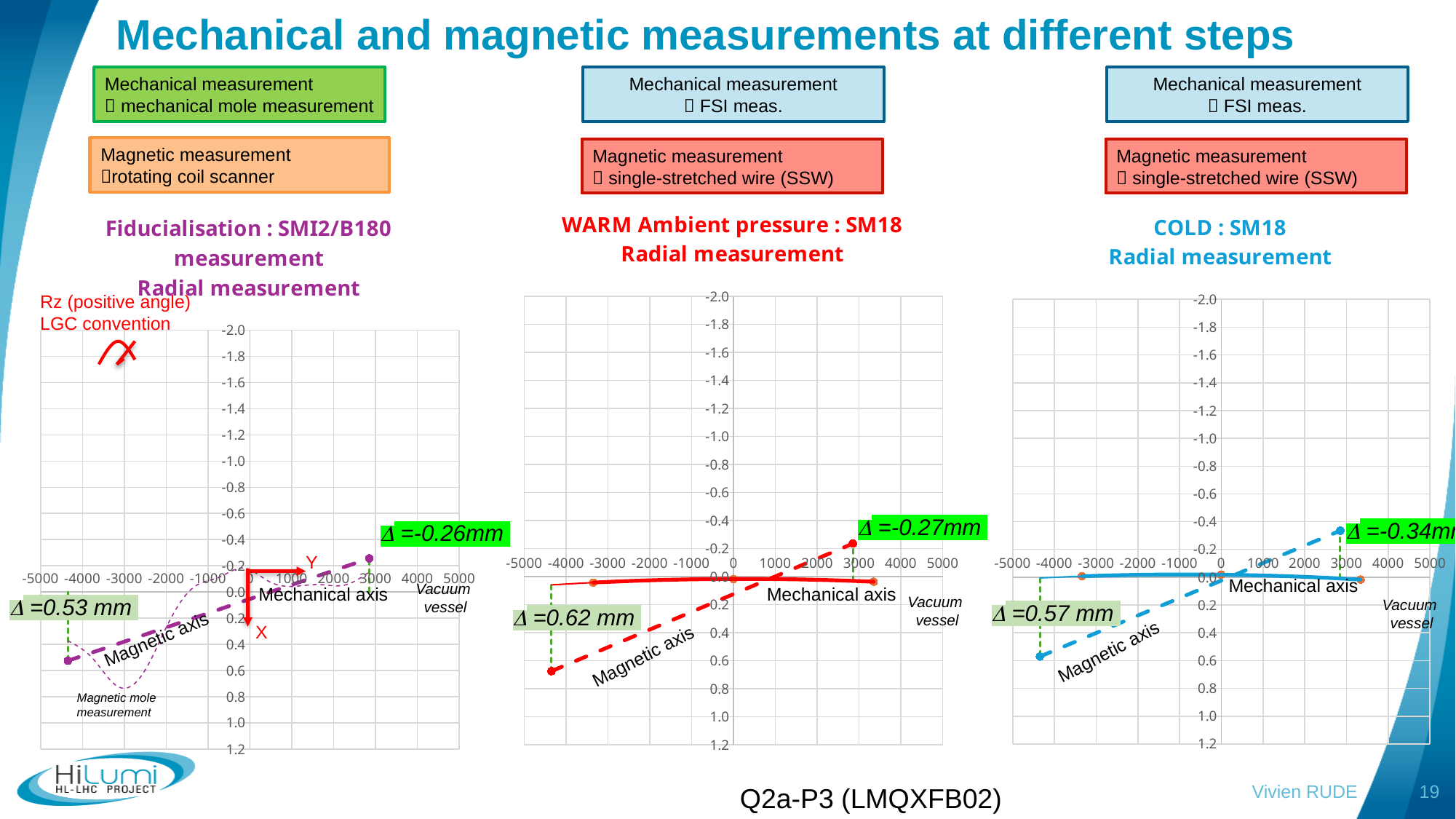
On the middle chart (WARM Ambient pressure : SM18), is the magnetic axis value at its left end greater or less than 0.4? greater What is the difference between the left-end Δ value on the WARM chart (0.62 mm) and the left-end Δ value on the Fiducialisation chart (0.53 mm)? 0.09 mm On the middle chart (WARM Ambient pressure : SM18), what is the Δ value annotated at the right end of the magnetic axis? -0.27mm On the middle chart (WARM Ambient pressure : SM18), what is the Δ value annotated at the left end of the magnetic axis? 0.62 mm What is the title of the right chart? COLD : SM18 Radial measurement On the right chart (COLD : SM18), what is the Δ value annotated at the left end of the magnetic axis? 0.57 mm What kind of chart is the middle chart (WARM Ambient pressure : SM18)? Line chart On the left chart (Fiducialisation : SMI2/B180), what is the Δ value annotated at the left end of the magnetic axis? 0.53 mm On the left chart (Fiducialisation : SMI2/B180), what is the Δ value annotated at the right end of the magnetic axis? -0.26mm On the middle chart (WARM Ambient pressure : SM18), what is the topmost y-axis tick label? -2.0 How many charts are shown on the slide? 3 Which chart shows the larger left-end Δ value, the WARM Ambient pressure chart or the COLD chart? WARM Ambient pressure